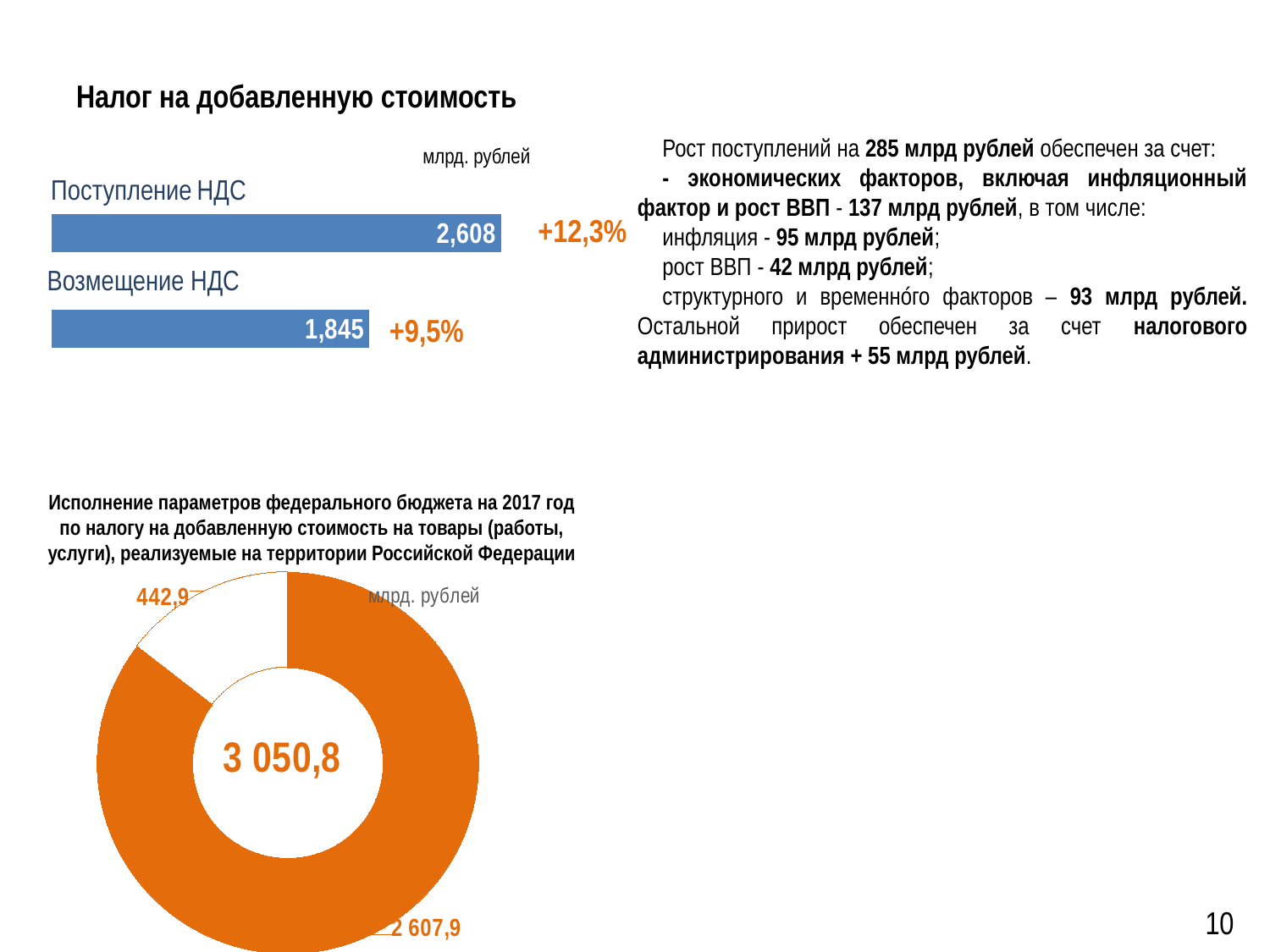
What type of chart is shown at the top-left of the slide? Bar chart In the top-left bar chart, what is the value for Поступление НДС? 2,608 In the bottom-left doughnut chart, what value is shown for the large orange segment? 2 607,9 In the top-left bar chart, how many bars are plotted? 2 In the top-left bar chart, what is the difference between the Поступление НДС and Возмещение НДС values? 763 In the top-left bar chart, what growth percentage is shown next to the Возмещение НДС bar? +9,5% In the bottom-left doughnut chart, what total value is printed in the centre? 3 050,8 In the bottom-left doughnut chart, what is the difference between the two segment values, 2 607,9 and 442,9? 2 165,0 What type of chart is shown at the bottom-left of the slide? Doughnut chart In the top-left bar chart, what growth percentage is shown next to the Поступление НДС bar? +12,3% In the top-left bar chart, what is the value for Возмещение НДС? 1,845 In the top-left bar chart, which category has the higher value, Поступление НДС or Возмещение НДС? Поступление НДС